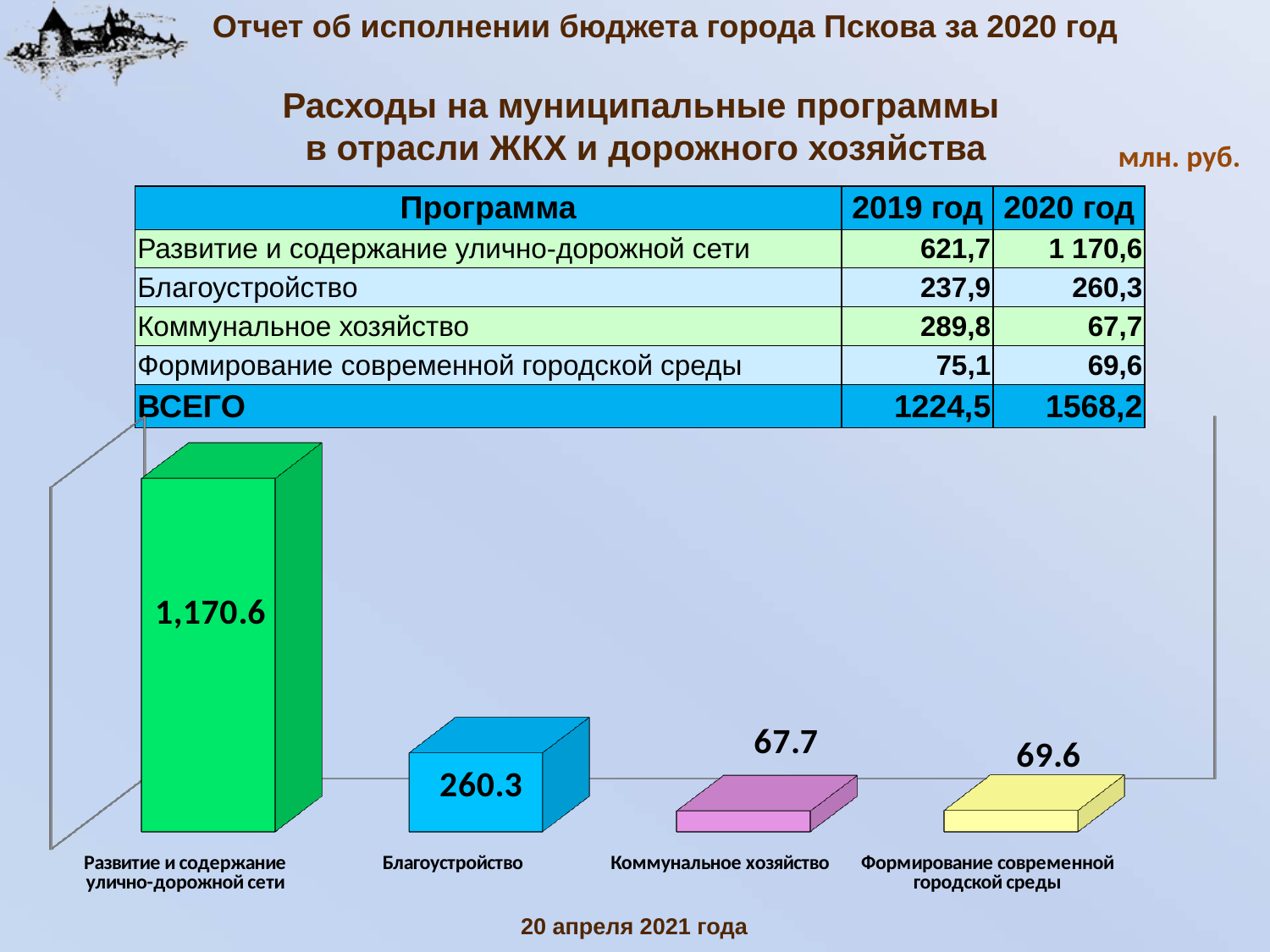
What is the value shown for Развитие и содержание улично-дорожной сети in the bar chart? 1,170.6 What is the difference between the values for Развитие и содержание улично-дорожной сети and Благоустройство in the bar chart? 910.3 What is the difference between the values for Формирование современной городской среды and Коммунальное хозяйство in the bar chart? 1.9 In the bar chart, which is larger: the value for Благоустройство or the value for Коммунальное хозяйство? Благоустройство What is the value shown for Коммунальное хозяйство in the bar chart? 67.7 What colour is the bar for Развитие и содержание улично-дорожной сети? green How many categories are shown in the bar chart? 4 Which category has the lowest value in the bar chart? Коммунальное хозяйство Which category has the highest value in the bar chart? Развитие и содержание улично-дорожной сети What kind of chart is shown on the slide? bar chart What is the value shown for Благоустройство in the bar chart? 260.3 What is the value shown for Формирование современной городской среды in the bar chart? 69.6